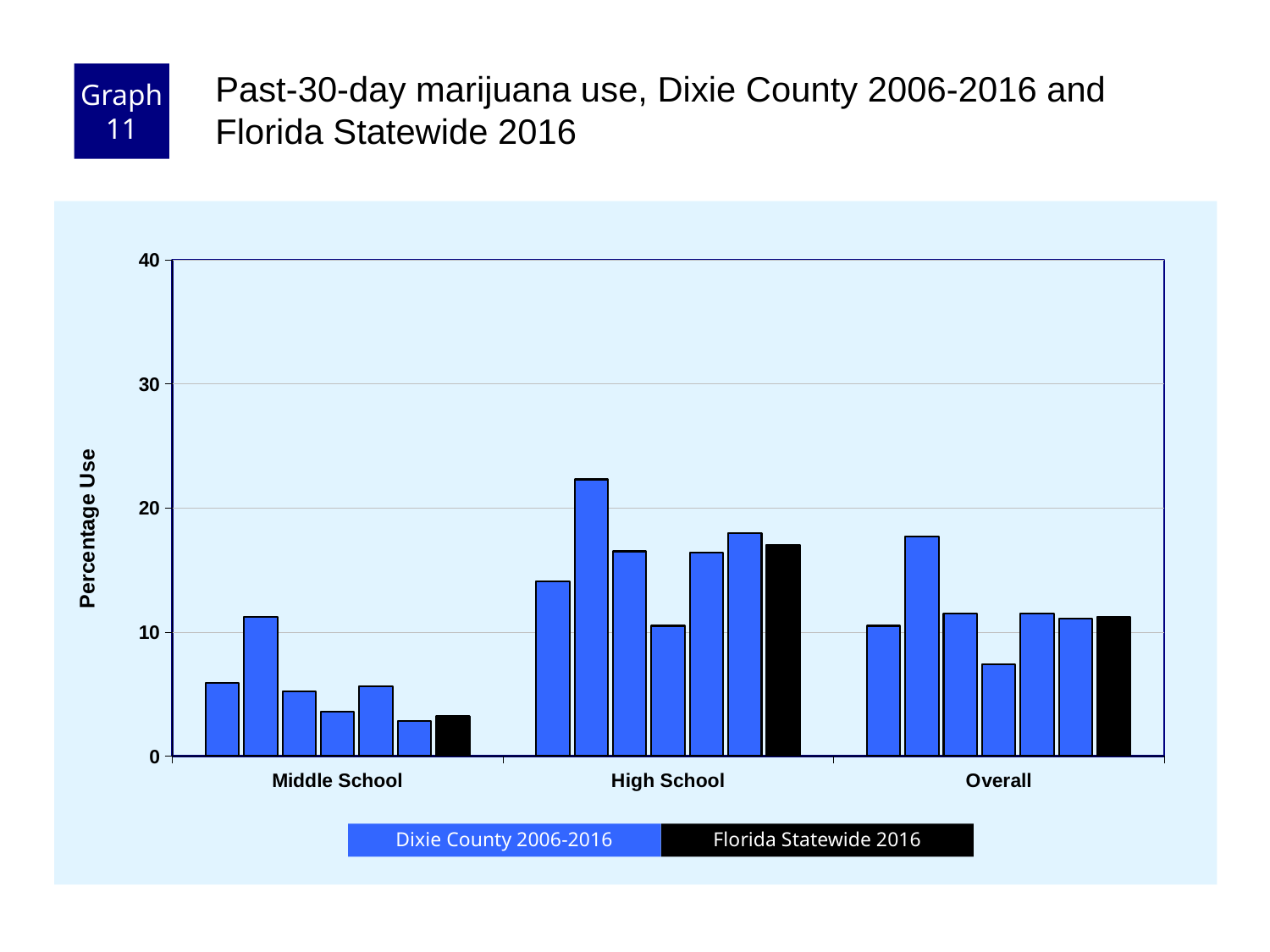
How many school-level categories are shown on the x axis? 3 Is the tallest Dixie County 2006-2016 bar for High School greater or less than 20? greater In which category is the Florida Statewide 2016 bar the highest? High School Which is larger, the Florida Statewide 2016 value for High School or for Overall? High School Is the Florida Statewide 2016 value for Overall greater or less than 20? less What is the label of the y axis? Percentage Use What are the three categories on the x axis? Middle School, High School, Overall How many series does the legend list? 2 In which category is the Florida Statewide 2016 bar the lowest? Middle School Is the Florida Statewide 2016 value for High School greater or less than 10? greater What kind of chart is shown on the slide? bar chart